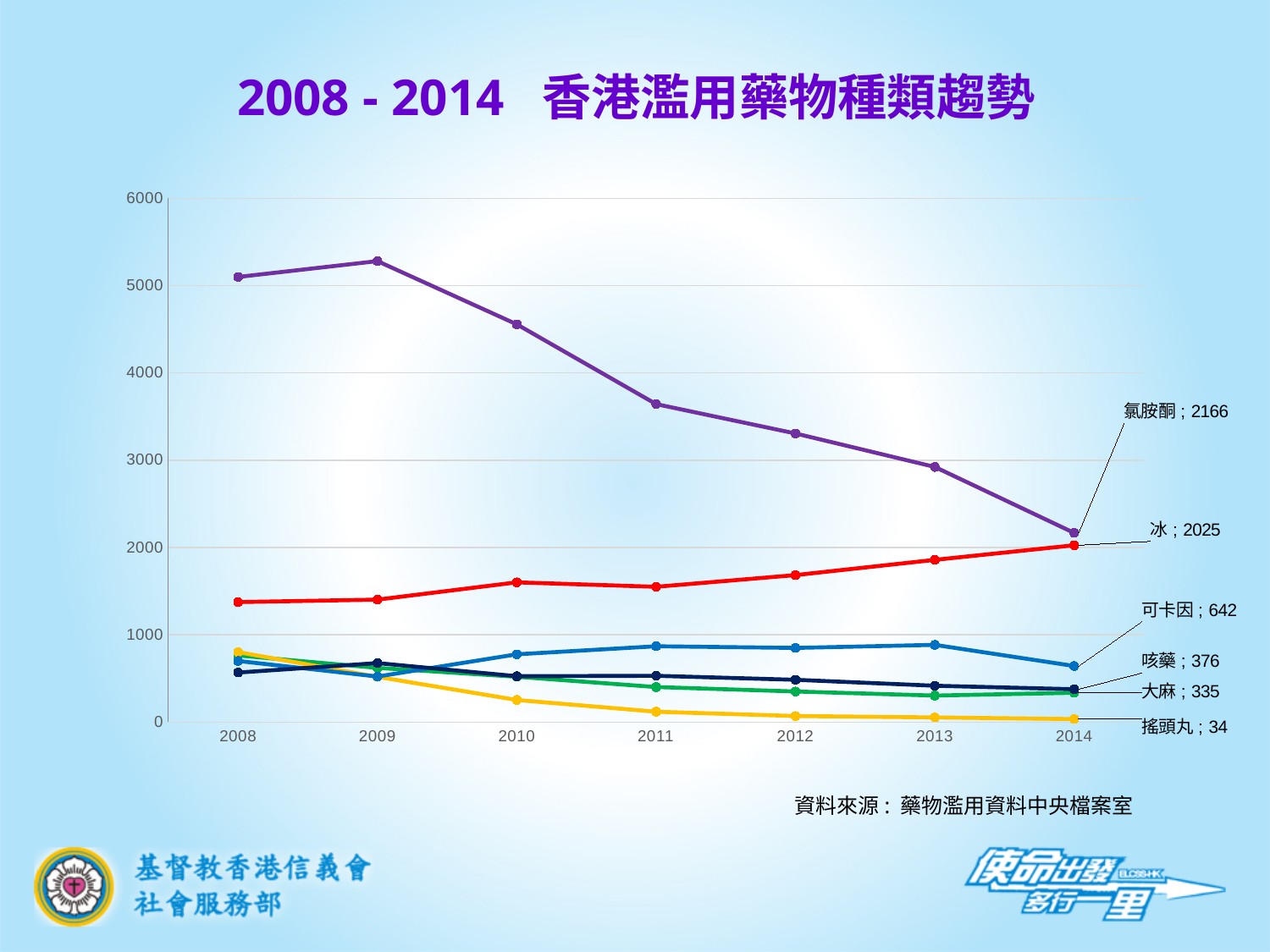
Does the line for 氯胺酮 rise or fall from 2009 to 2014? fall What is the difference between the 2014 values for 氯胺酮 and 冰? 141 What is the value for 冰 in 2014? 2025 Is the value for 氯胺酮 in 2008 greater or less than 5000? greater In 2014, which is larger: 可卡因 or 咳藥? 可卡因 What is the value for 搖頭丸 in 2014? 34 How many years are shown on the x axis? 7 What is the value for 可卡因 in 2014? 642 What is the value for 氯胺酮 in 2014? 2166 Is the value for 氯胺酮 in 2011 greater or less than 3000? greater What is the difference between the 2014 values for 咳藥 and 大麻? 41 Which drug type has the highest value in 2014? 氯胺酮